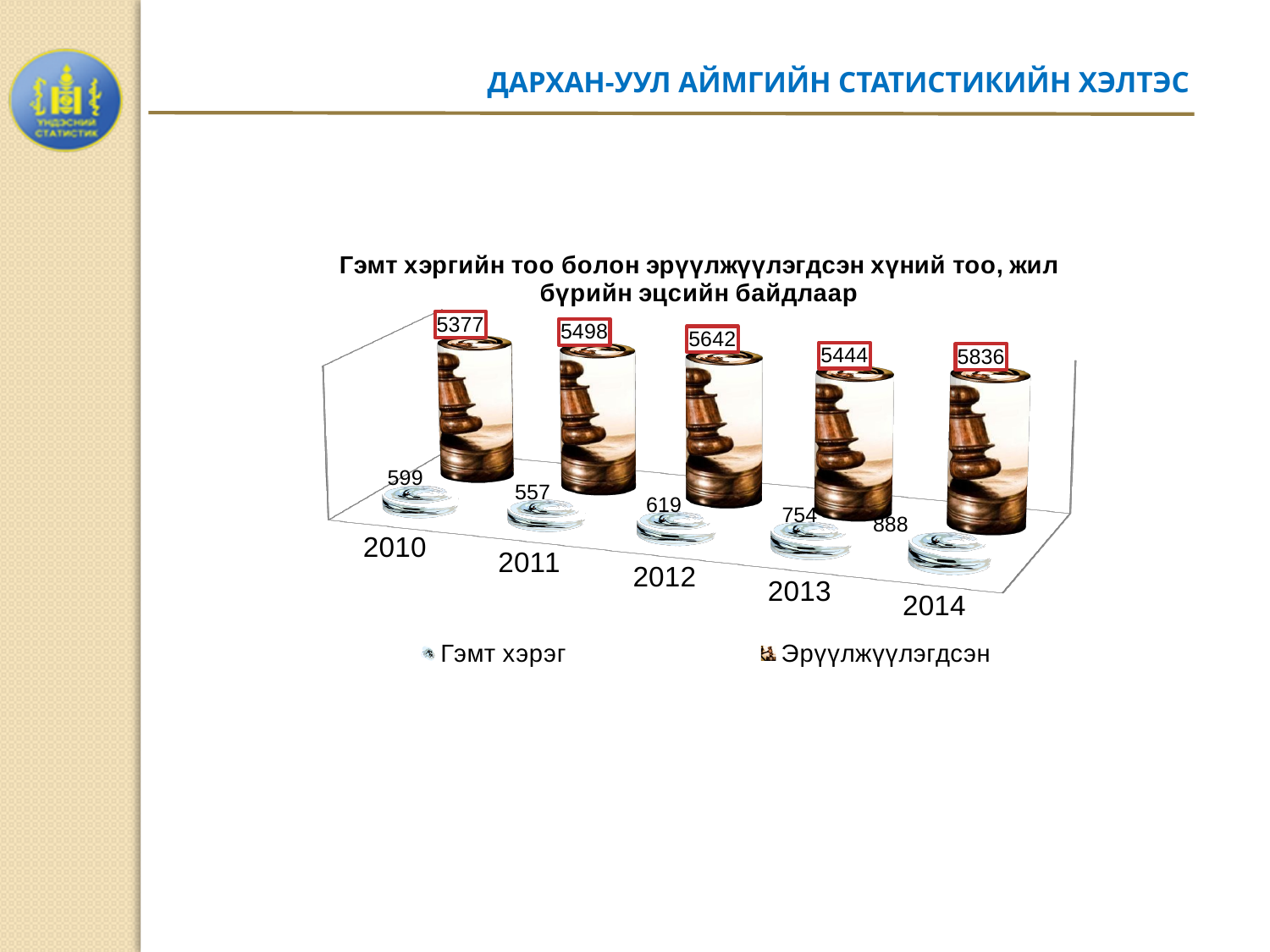
What is the value for Гэмт хэрэг in 2010? 599 In which year is the Эрүүлжүүлэгдсэн value highest? 2014 What is the difference between the Гэмт хэрэг values for 2014 and 2013? 134 In which year is the Гэмт хэрэг value lowest? 2011 How many years are shown on the x axis? 5 What is the value for Эрүүлжүүлэгдсэн in 2013? 5444 How many series does the legend list? 2 Which is larger, the Эрүүлжүүлэгдсэн value for 2011 or for 2013? 2011 What kind of chart is shown on the slide? bar chart What is the value for Гэмт хэрэг in 2014? 888 What is the difference between the Эрүүлжүүлэгдсэн values for 2012 and 2010? 265 What is the value for Эрүүлжүүлэгдсэн in 2012? 5642